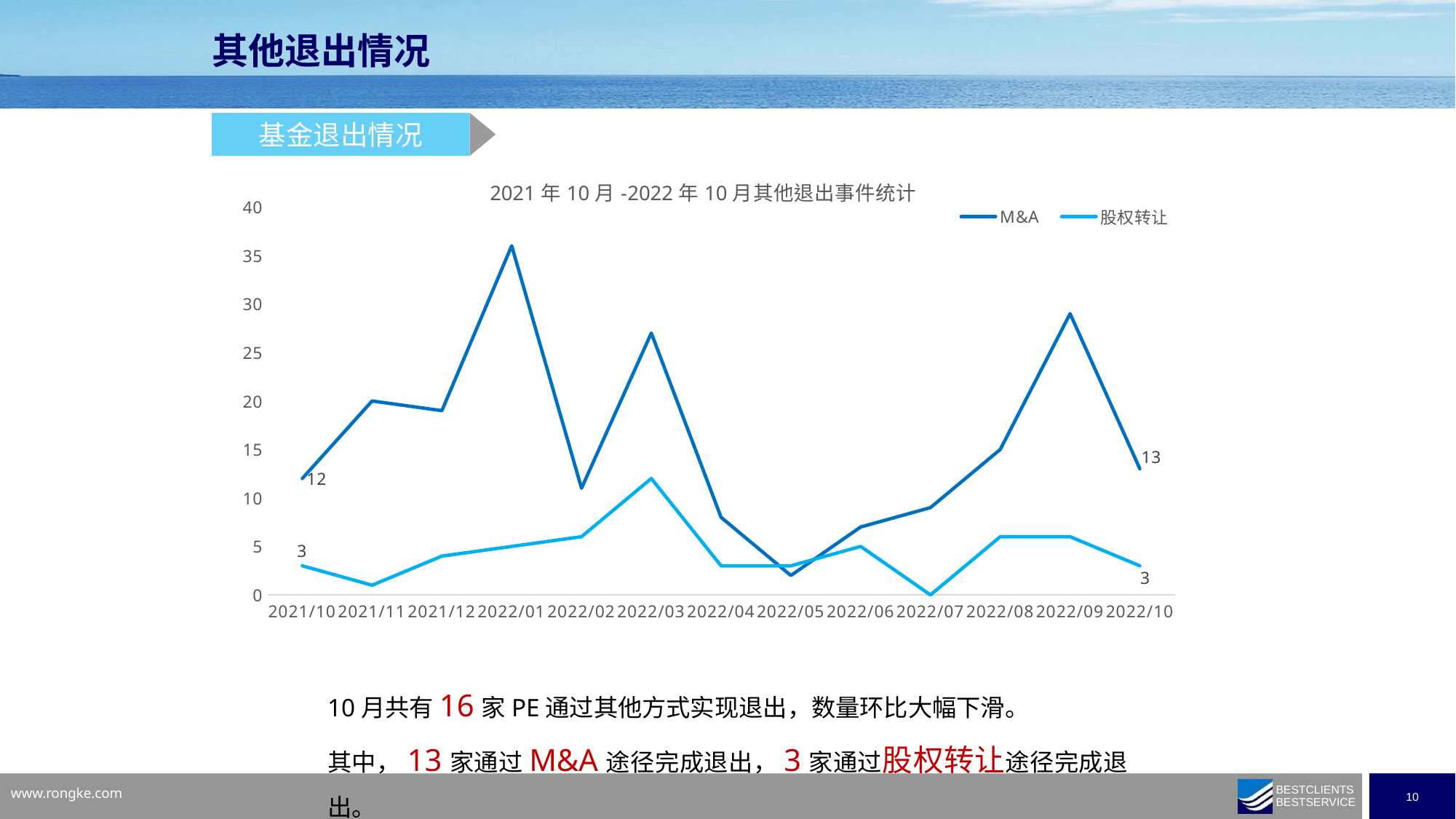
How many series does the legend list? 2 What is the M&A value for 2022/10? 13 What is the M&A value for 2021/10? 12 What is the 股权转让 value for 2022/10? 3 What kind of chart is shown on the slide? line chart Which is larger for M&A: the value in 2021/10 or the value in 2022/10? 2022/10 Is the M&A value for 2022/01 greater or less than 30? greater In which month does the 股权转让 series reach its lowest value? 2022/07 How many months are shown on the x axis? 13 What is the 股权转让 value for 2021/10? 3 In which month does the M&A series reach its highest value? 2022/01 What is the difference between the M&A value and the 股权转让 value in 2022/10? 10